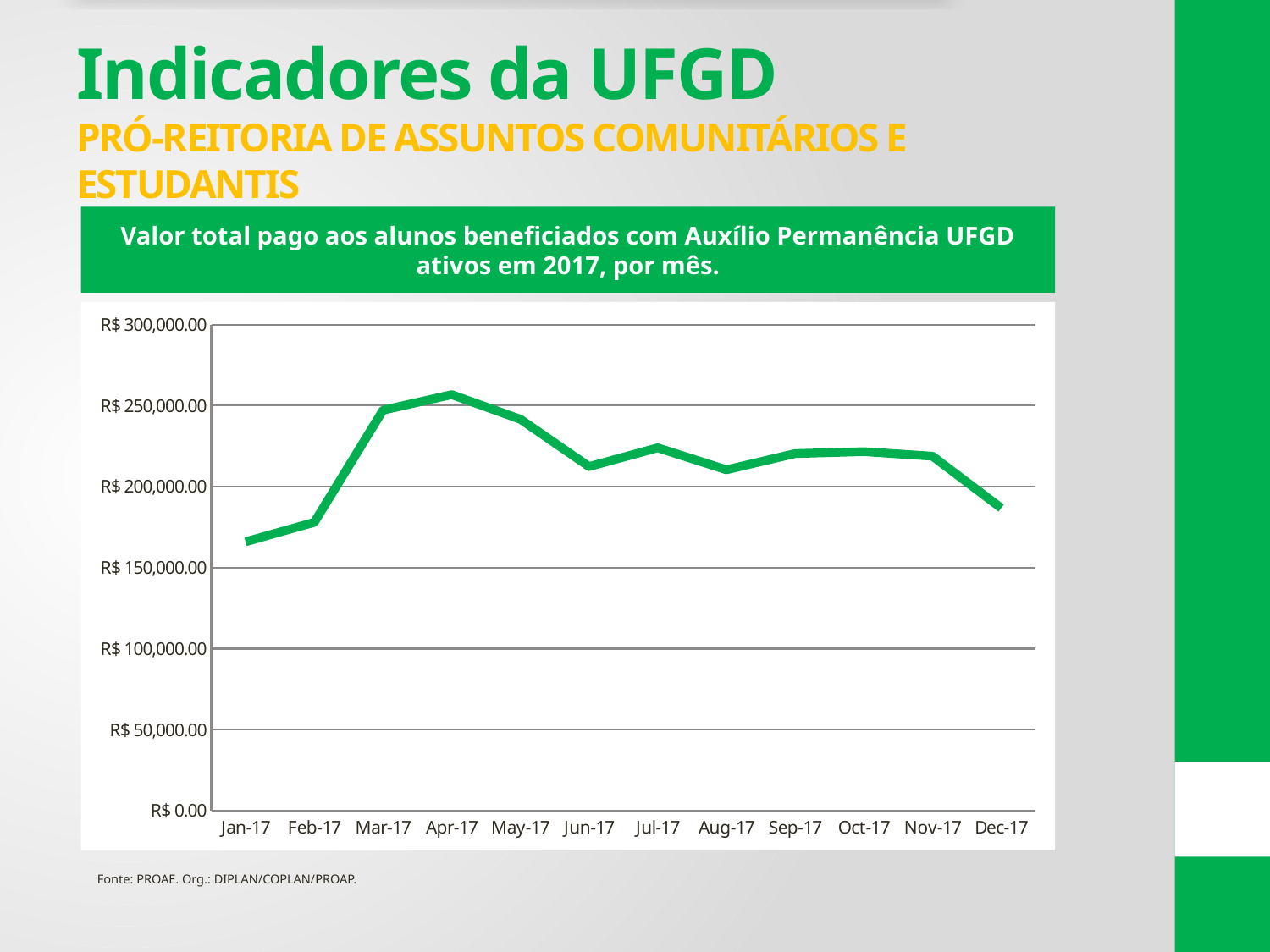
Is the value for Apr-17 greater or less than R$ 250,000.00? greater Do the values rise or fall from Jan-17 to Apr-17? rise Is the value for Jan-17 greater or less than R$ 200,000.00? less Is the value for Jun-17 greater or less than R$ 200,000.00? greater Which month has the lowest value paid? Jan-17 Which is larger, the value for Jan-17 or the value for Dec-17? Dec-17 What is the highest tick value shown on the y axis? R$ 300,000.00 What kind of chart is shown on the slide? line chart How many months are plotted along the x axis? 12 Which is larger, the value for Feb-17 or the value for Mar-17? Mar-17 Which month has the highest value paid? Apr-17